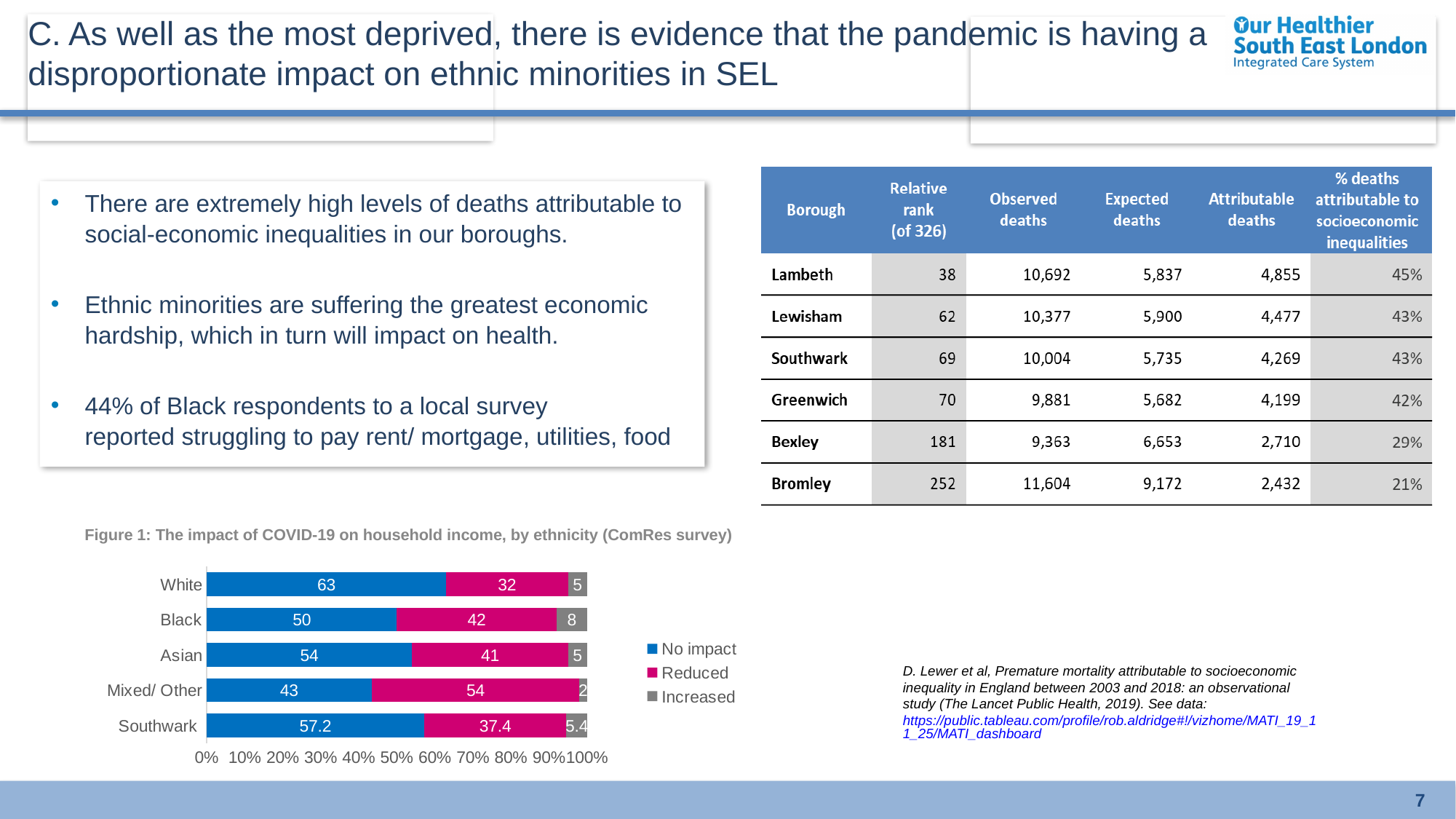
In Figure 1, which series is shown in pink? Reduced What kind of chart is Figure 1 on the slide? Stacked bar chart How many series does the legend of Figure 1 list? 3 In Figure 1, what is the 'No impact' value for White respondents? 63 In Figure 1, what is the 'Increased' value for Southwark? 5.4 In Figure 1, what is the 'Reduced' value for Mixed/ Other respondents? 54 In Figure 1, what is the 'Reduced' value for Black respondents? 42 In Figure 1, is the 'Reduced' value larger for Asian or for White respondents? Asian How many categories are shown on the y axis of Figure 1? 5 In Figure 1, what is the difference between the 'No impact' values for White and Black respondents? 13 In Figure 1, which category has the lowest 'No impact' value? Mixed/ Other In Figure 1, which category has the highest 'No impact' value? White